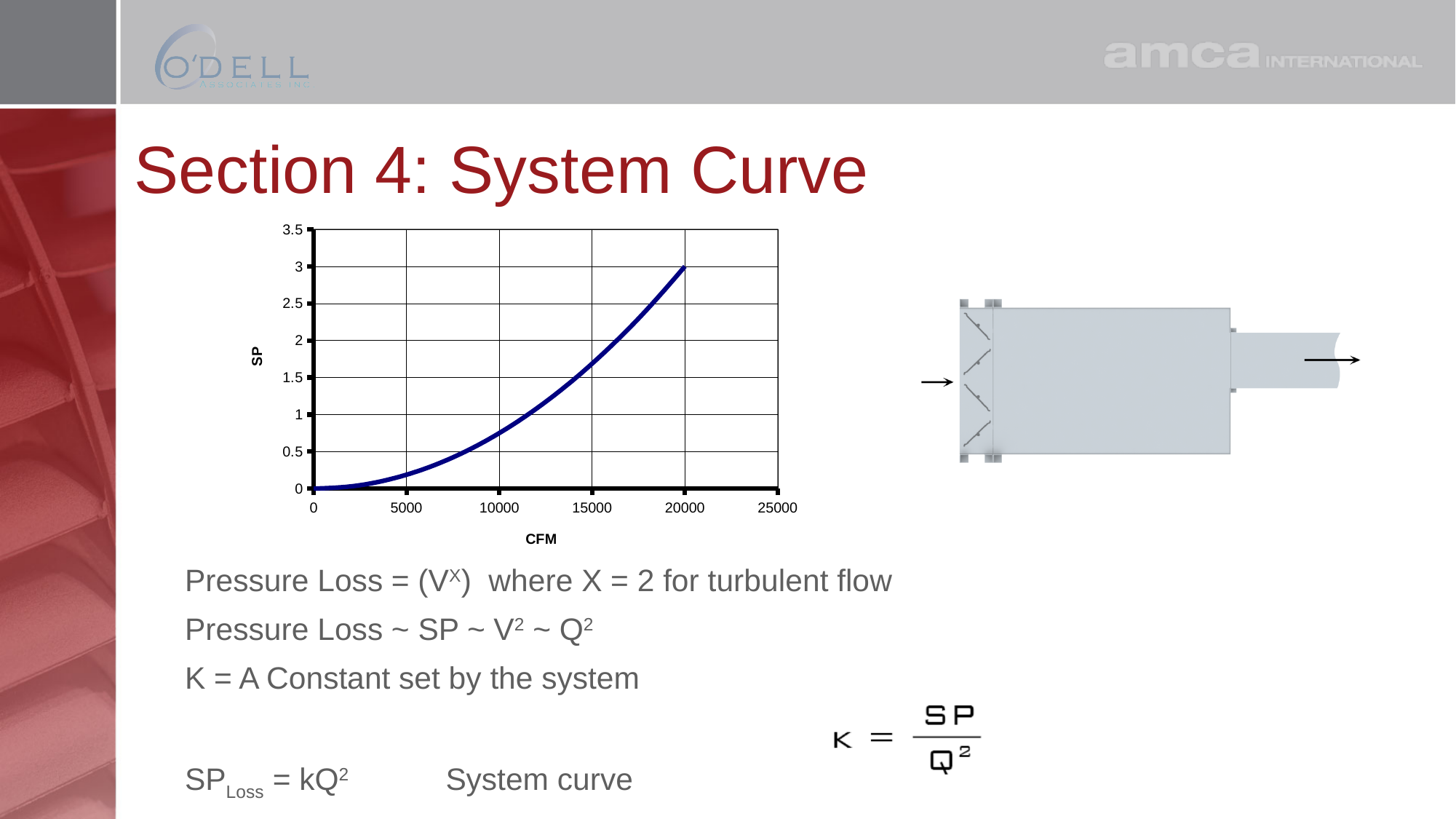
What is the label of the y axis of the chart? SP Is the SP value at 15000 CFM greater or less than 2? less Is the SP value at 10000 CFM greater or less than 1? less How many curves are plotted on the chart? 1 What is the label of the x axis of the chart? CFM Does the SP value rise or fall as CFM increases along the x axis? rise Is the SP value at 5000 CFM greater or less than 0.5? less What is the highest value shown on the x axis of the chart? 25000 What is the SP value where the curve ends at 20000 CFM? 3 What kind of chart is shown on the slide? line chart What is the SP value at 0 CFM? 0